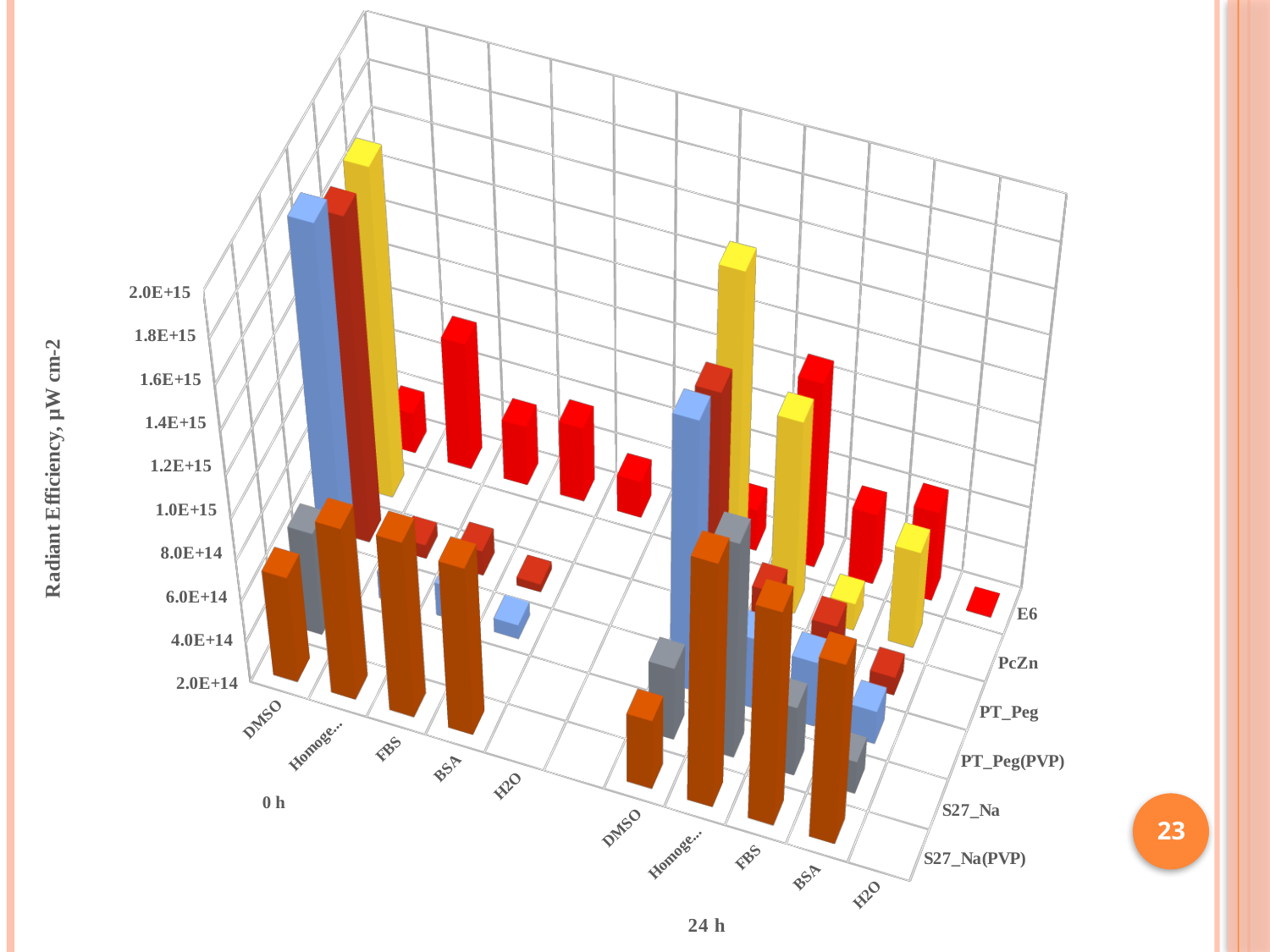
In the 0 h group, is the S27_Na value for Homoge... greater or less than 1.0E+15? less What colour are the bars for the E6 series? red In the 0 h group, is the PT_Peg value for H2O greater or less than 1.0E+15? less How many series are listed on the chart's depth axis (E6 through S27_Na(PVP))? 6 How many time groups are plotted on the chart? 2 In the 24 h group, which category has the tallest E6 bar? Homoge... What is the title of the vertical axis? Radiant Efficiency, µW cm-2 In the 24 h group, is the S27_Na value for Homoge... greater or less than 1.0E+15? greater What kind of chart is shown on the slide? bar chart In the 0 h group, is the E6 bar larger for Homoge... or for DMSO? Homoge... How many solvent categories (DMSO, Homoge..., FBS, BSA, H2O) are plotted in each time group? 5 In the 0 h group, which category has the tallest E6 bar? Homoge...